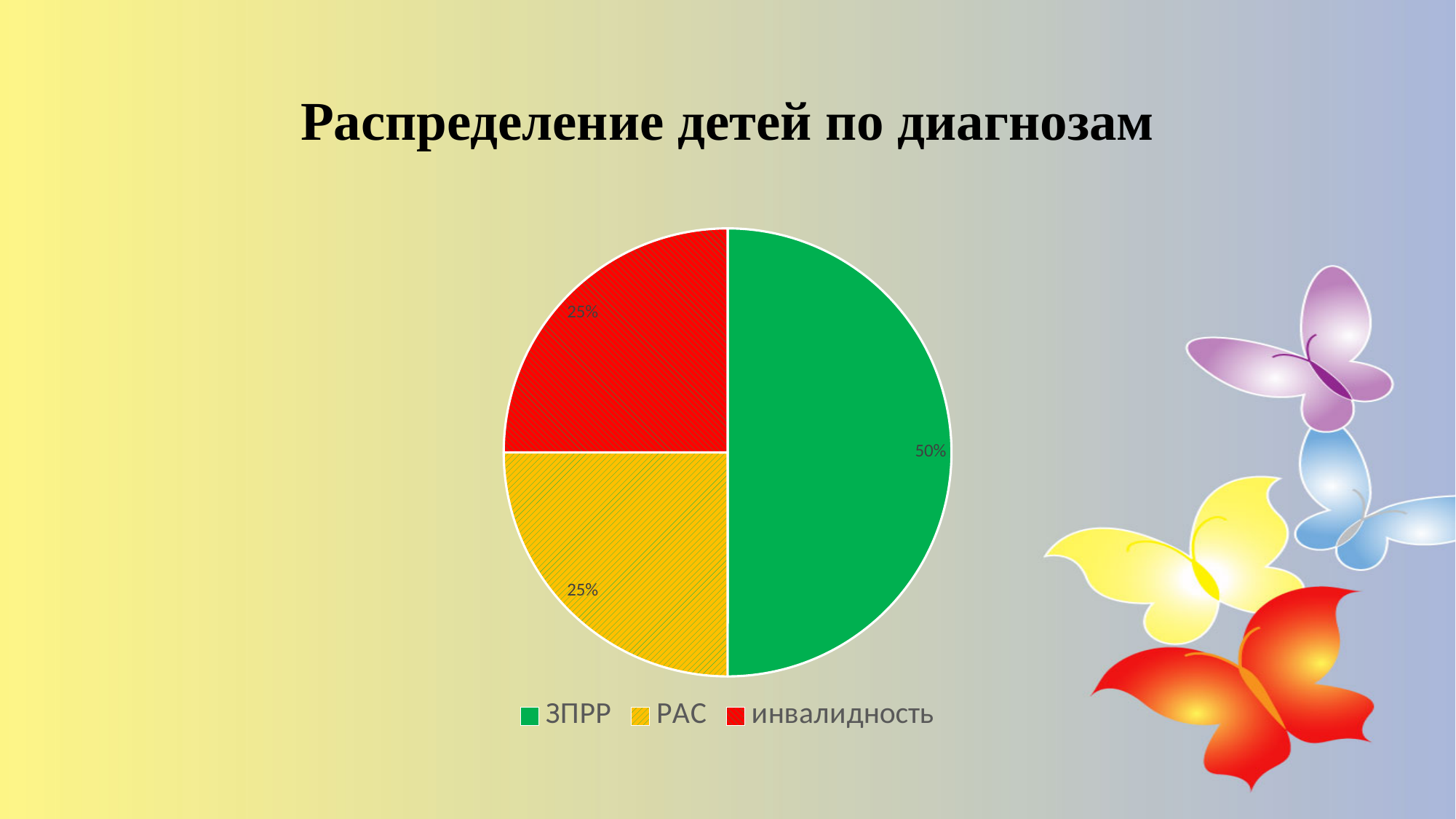
Which is larger, the slice for ЗПРР or the slice for РАС? ЗПРР Is the share for ЗПРР greater or less than 40%? greater What colour is the slice for инвалидность? red What share of the pie does инвалидность take? 25% What is the difference between the share for ЗПРР and the share for инвалидность? 25% How many categories does the legend list? 3 What share of the pie does ЗПРР take? 50% Which category has the largest slice of the pie? ЗПРР What share of the pie does РАС take? 25% What is the title of the chart? Распределение детей по диагнозам What kind of chart is shown on the slide? pie chart